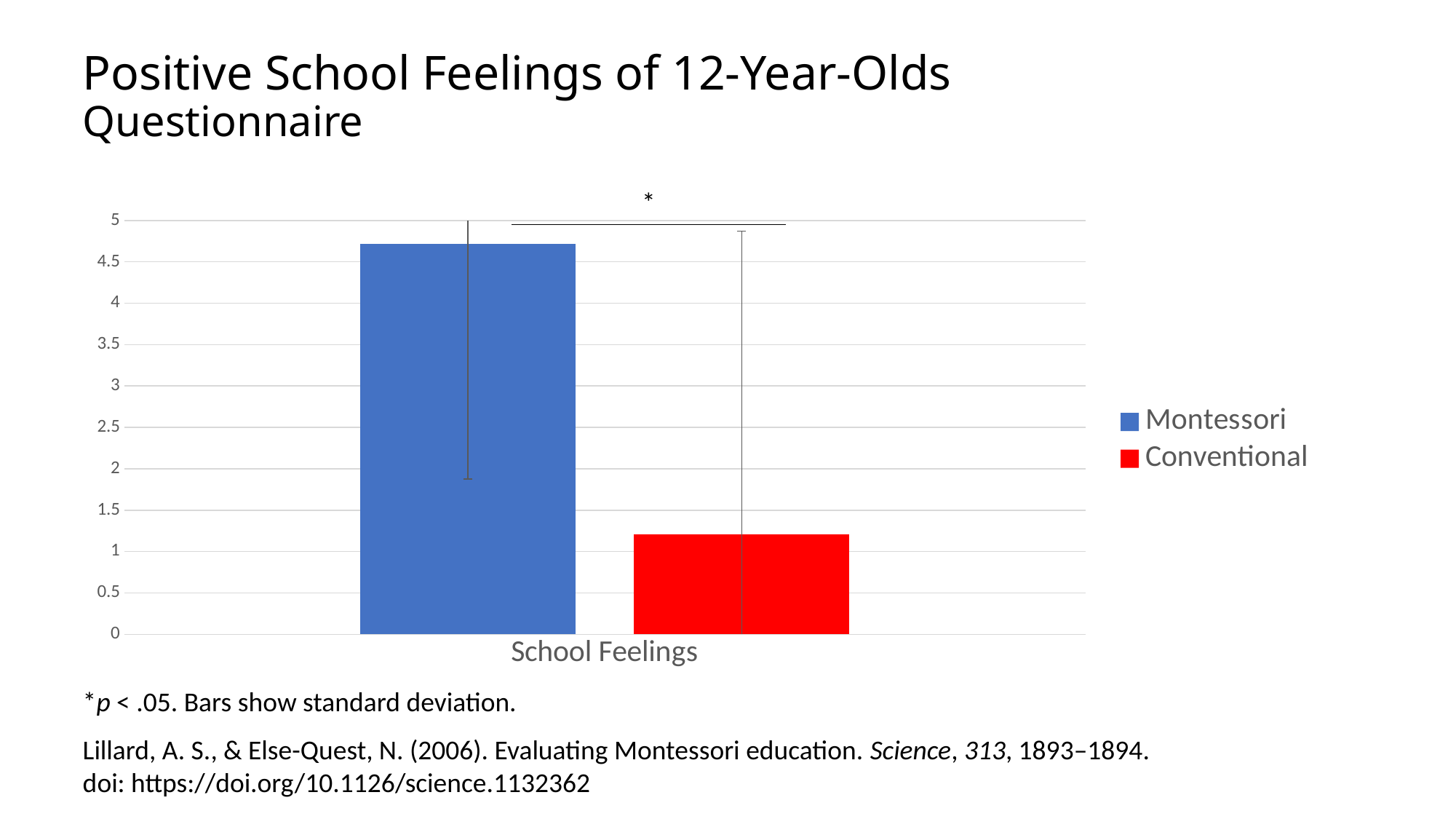
Is the Montessori bar taller or shorter than the Conventional bar? taller Is the value for Conventional greater or less than 1.5? less Which series has the lower value for School Feelings? Conventional How many categories are shown on the x axis? 1 Is the value for Montessori greater or less than 4? greater Is the value for Conventional greater or less than 2? less What kind of chart is shown on the slide? bar chart Which colour represents the Conventional series in the legend? red Which series has the higher value for School Feelings? Montessori How many series does the legend list? 2 What is the label of the category on the x axis? School Feelings